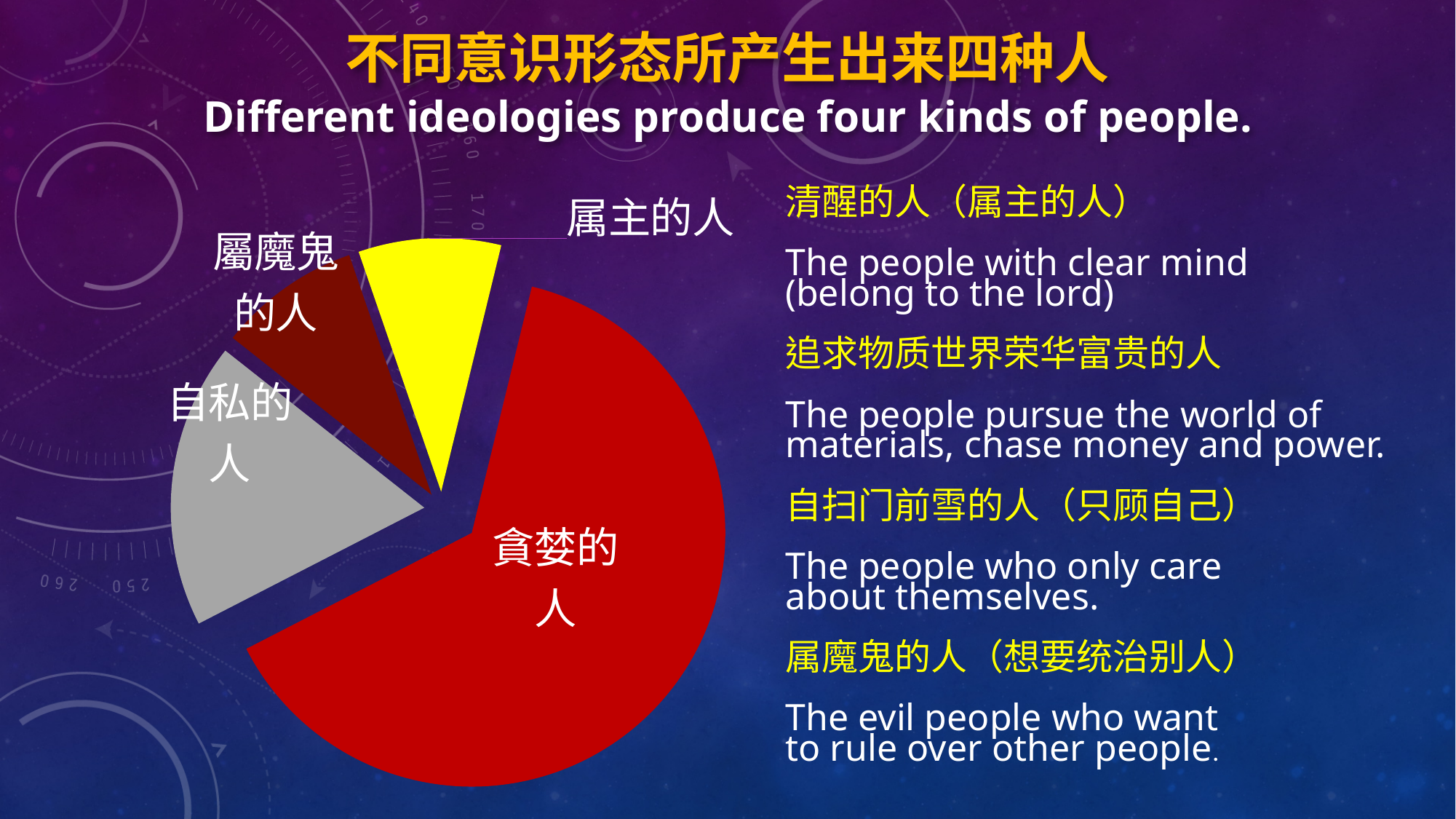
What kind of chart is shown on the slide? pie chart Which slice is larger, 自私的人 or 属主的人? 自私的人 Which category has the largest slice in the pie chart? 貪婪的人 Does the slice for 貪婪的人 take up more or less than half of the pie? more How many slices does the pie chart have? 4 Which slice is larger, 貪婪的人 or 自私的人? 貪婪的人 What colour is the slice labelled 自私的人? gray What colour is the slice labelled 属主的人? yellow Which slice is larger, 自私的人 or 屬魔鬼的人? 自私的人